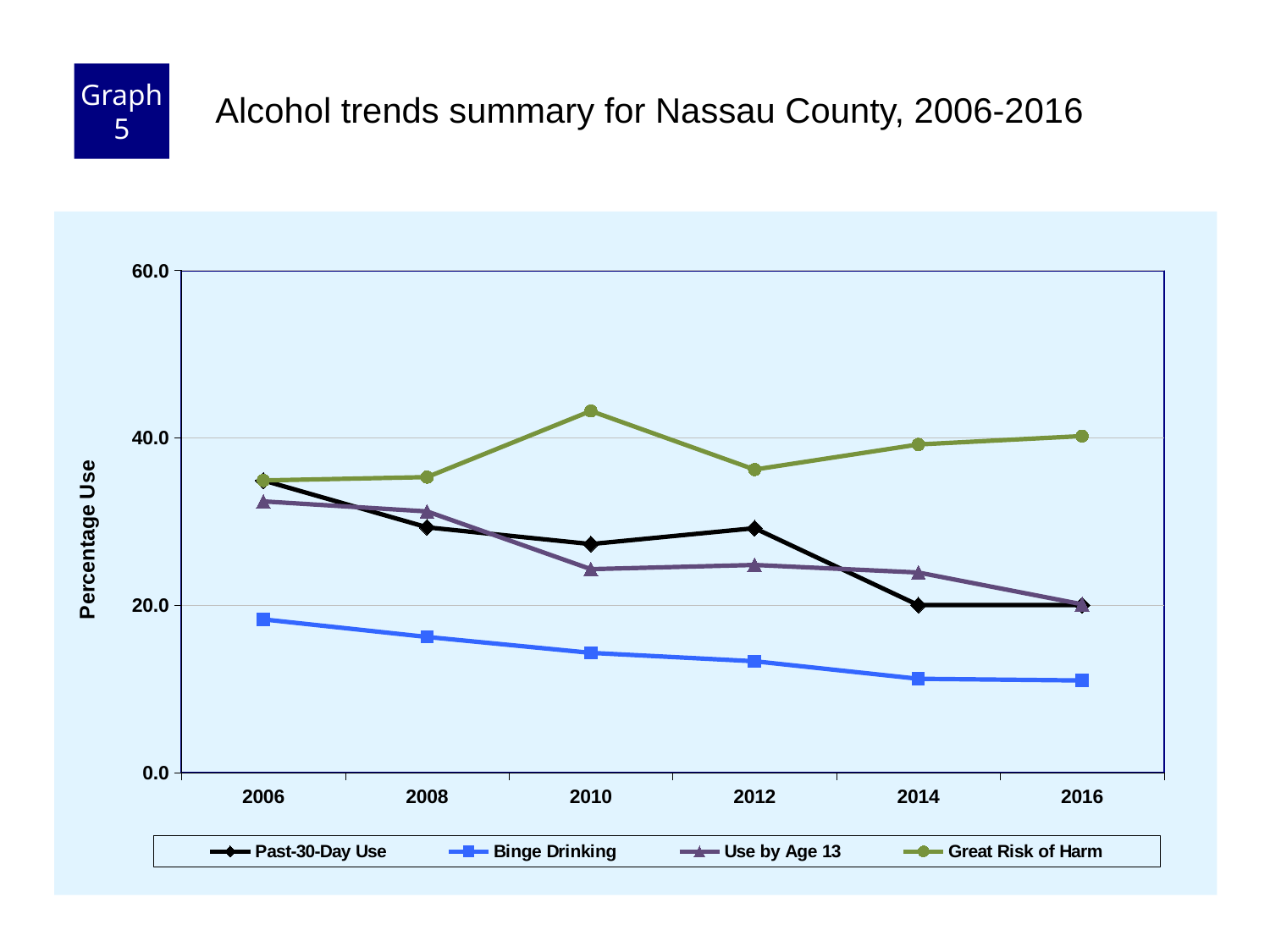
In which year does the Great Risk of Harm series reach its highest value? 2010 What is the label on the y axis? Percentage Use What is the title of the slide's chart? Alcohol trends summary for Nassau County, 2006-2016 How many years are plotted along the x axis? 6 Which series has the lowest value in 2010? Binge Drinking What kind of chart is shown on the slide? line chart Does the Binge Drinking series rise or fall from 2006 to 2016? fall How many series does the legend list? 4 Is the value for Great Risk of Harm in 2010 greater or less than 40.0? greater In 2012, which is larger: Past-30-Day Use or Use by Age 13? Past-30-Day Use Which series has the highest value in 2016? Great Risk of Harm Is the value for Binge Drinking in 2006 greater or less than 20.0? less